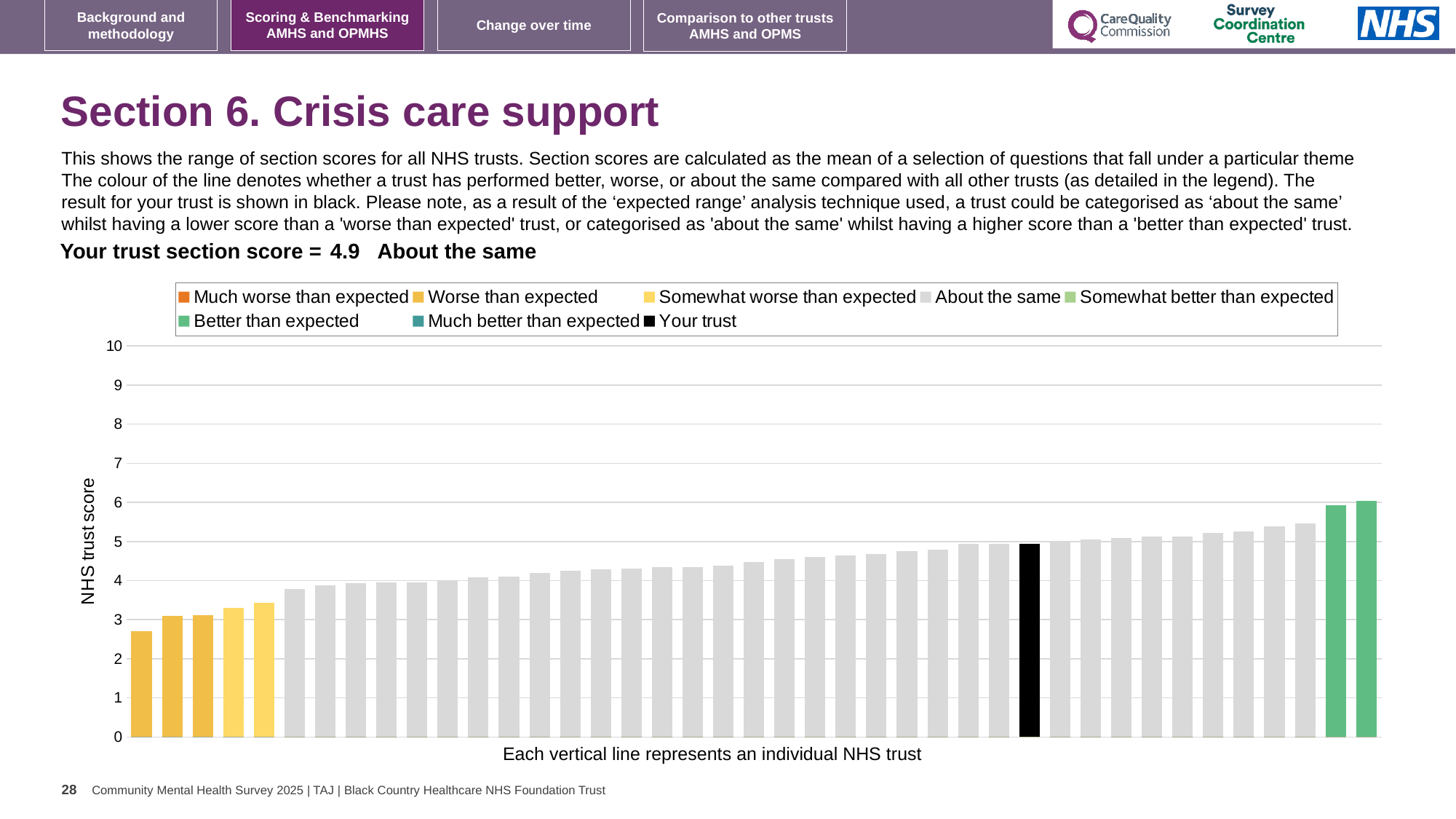
Is the value of the black 'Your trust' bar greater or less than 4? greater Is the value of the lowest (leftmost) bar greater or less than 3? less What kind of chart is shown on the slide? bar chart How many bars are coloured green (better than expected)? 2 Which category is your trust placed in according to the slide? About the same What is the section score for your trust shown on the slide? 4.9 How many entries does the chart legend list? 8 Which is larger, the leftmost bar or the rightmost bar? the rightmost bar What is the label on the y axis of the chart? NHS trust score Is the value of the highest (rightmost) bar greater or less than 5? greater Do the bar values rise or fall from left to right along the x axis? rise How many bars are coloured yellow/orange (worse or somewhat worse than expected)? 5